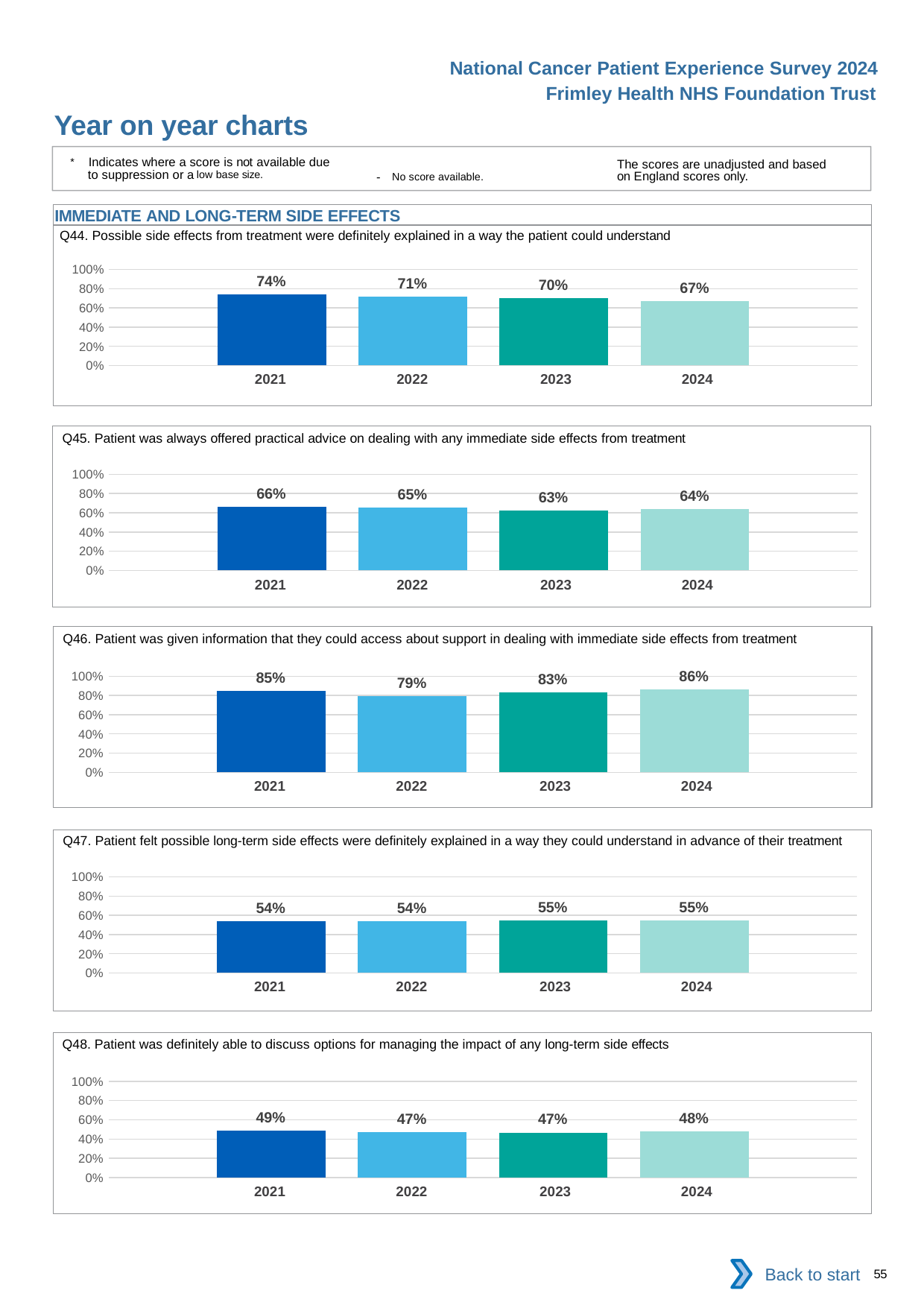
In the Q44 chart, what is the value for 2021? 74% In the Q47 chart, what is the value for 2024? 55% In the Q45 chart, what is the value for 2023? 63% In the Q48 chart, what is the value for 2021? 49% What kind of chart is the Q47 chart? Bar chart In the Q44 chart, which year has the lowest value? 2024 In the Q46 chart, what is the value for 2022? 79% In the Q46 chart, which is larger, the value for 2021 or the value for 2023? 2021 In the Q48 chart, how many years are shown on the x axis? 4 In the Q45 chart, which year has the highest value? 2021 In the Q44 chart, what is the difference between the 2021 and 2024 values? 7% In the Q46 chart, which year has the highest value? 2024